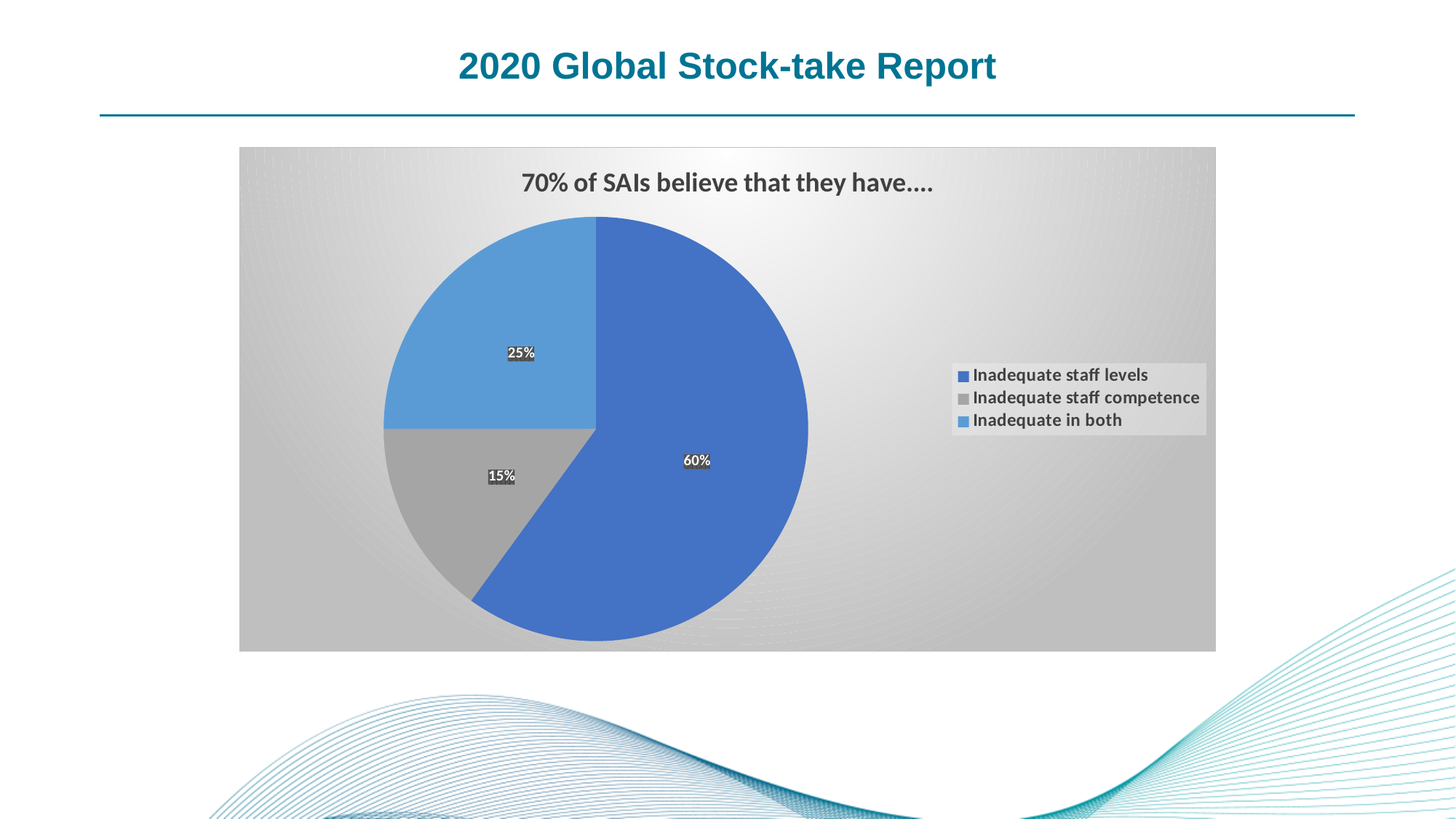
What share of the pie is labelled 'Inadequate staff competence'? 15% What is the difference between the shares for 'Inadequate in both' and 'Inadequate staff competence'? 10% What share of the pie is labelled 'Inadequate staff levels'? 60% What is the title of the chart? 70% of SAIs believe that they have.... How many slices does the pie chart have? 3 Which category has the smallest slice of the pie? Inadequate staff competence What is the difference between the shares for 'Inadequate staff levels' and 'Inadequate in both'? 35% Which is larger: the slice for 'Inadequate in both' or the slice for 'Inadequate staff competence'? Inadequate in both Which legend entry is shown in grey? Inadequate staff competence What kind of chart is shown on the slide? pie chart Which category has the largest slice of the pie? Inadequate staff levels What share of the pie is labelled 'Inadequate in both'? 25%